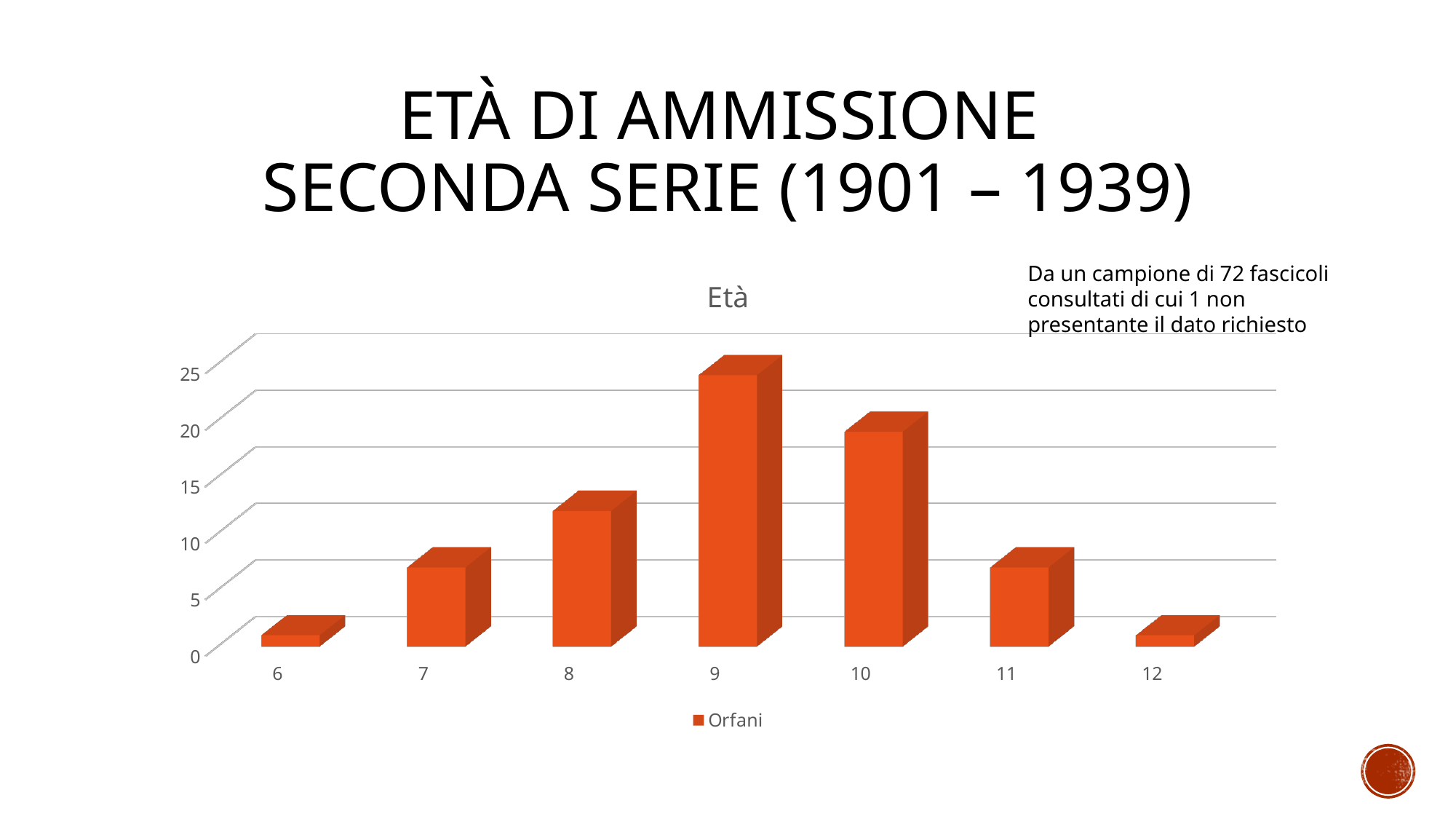
How many age categories are shown on the x axis of the chart? 7 How many series does the chart legend list? 1 Is the value for age 9 greater or less than 20? greater Which has the larger value, age 8 or age 11? 8 Which age category has the highest value in the chart? 9 Is the value for age 10 greater or less than 15? greater Is the value for age 6 greater or less than 5? less What is the title of the chart? Età Which has the larger value, age 9 or age 10? 9 What is the name of the series shown in the chart legend? Orfani What kind of chart is shown on the slide? bar chart